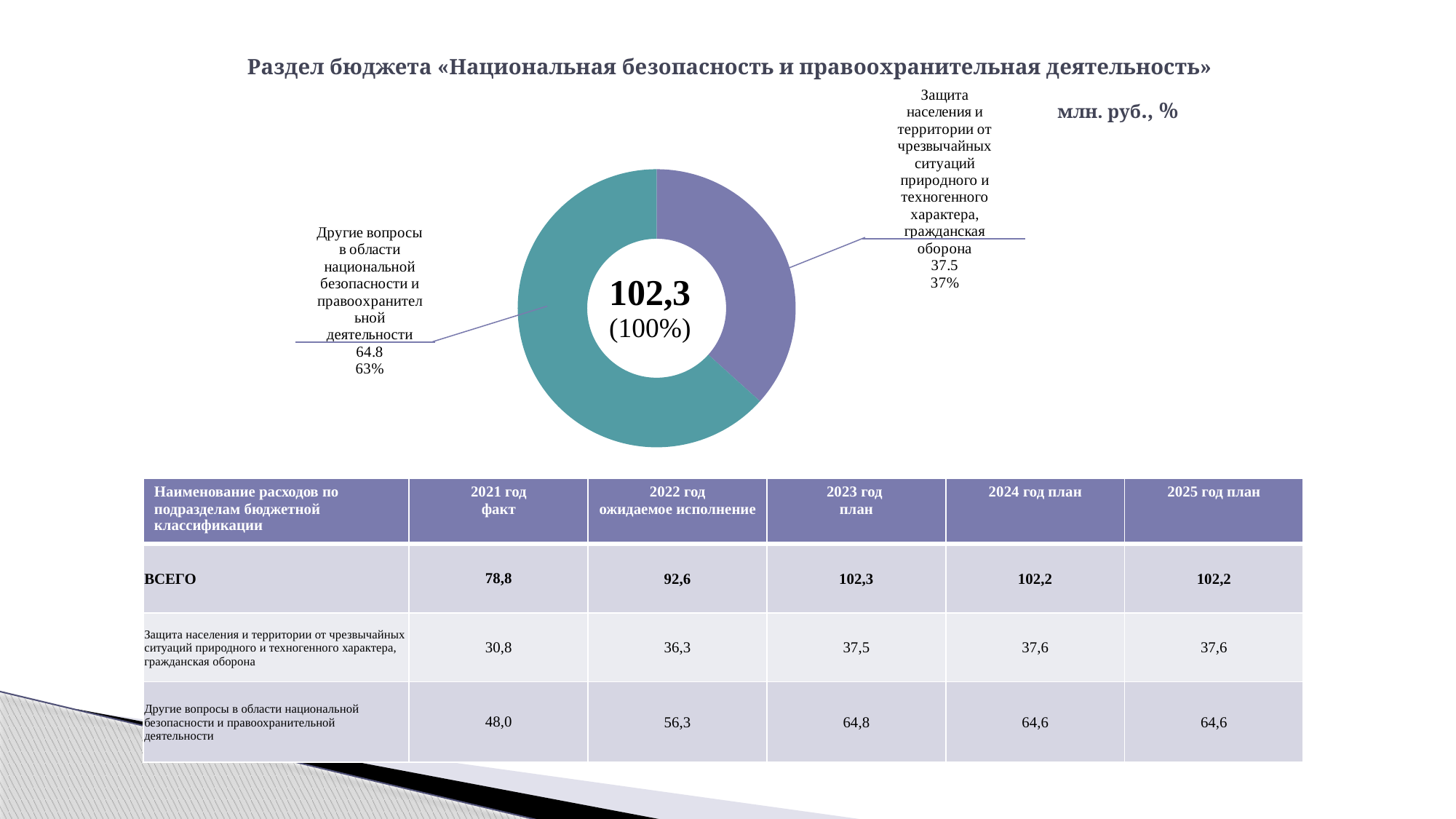
Which slice of the donut chart is the smallest? Защита населения и территории от чрезвычайных ситуаций природного и техногенного характера, гражданская оборона What share of the donut chart does «Другие вопросы в области национальной безопасности и правоохранительной деятельности» represent? 63% How many slices does the donut chart have? 2 Which slice of the donut chart is the largest? Другие вопросы в области национальной безопасности и правоохранительной деятельности What is the difference between the two slice values in the donut chart (64.8 and 37.5)? 27.3 What share of the donut chart does «Защита населения и территории от чрезвычайных ситуаций природного и техногенного характера, гражданская оборона» represent? 37% What value is shown for «Другие вопросы в области национальной безопасности и правоохранительной деятельности» in the donut chart? 64.8 What units are indicated for the donut chart values? млн. руб., % What kind of chart is shown on the slide? Pie (donut) chart Which is larger in the donut chart: «Защита населения...» or «Другие вопросы...»? Другие вопросы в области национальной безопасности и правоохранительной деятельности What total value is shown in the centre of the donut chart? 102,3 (100%) What value is shown for «Защита населения и территории от чрезвычайных ситуаций природного и техногенного характера, гражданская оборона» in the donut chart? 37.5